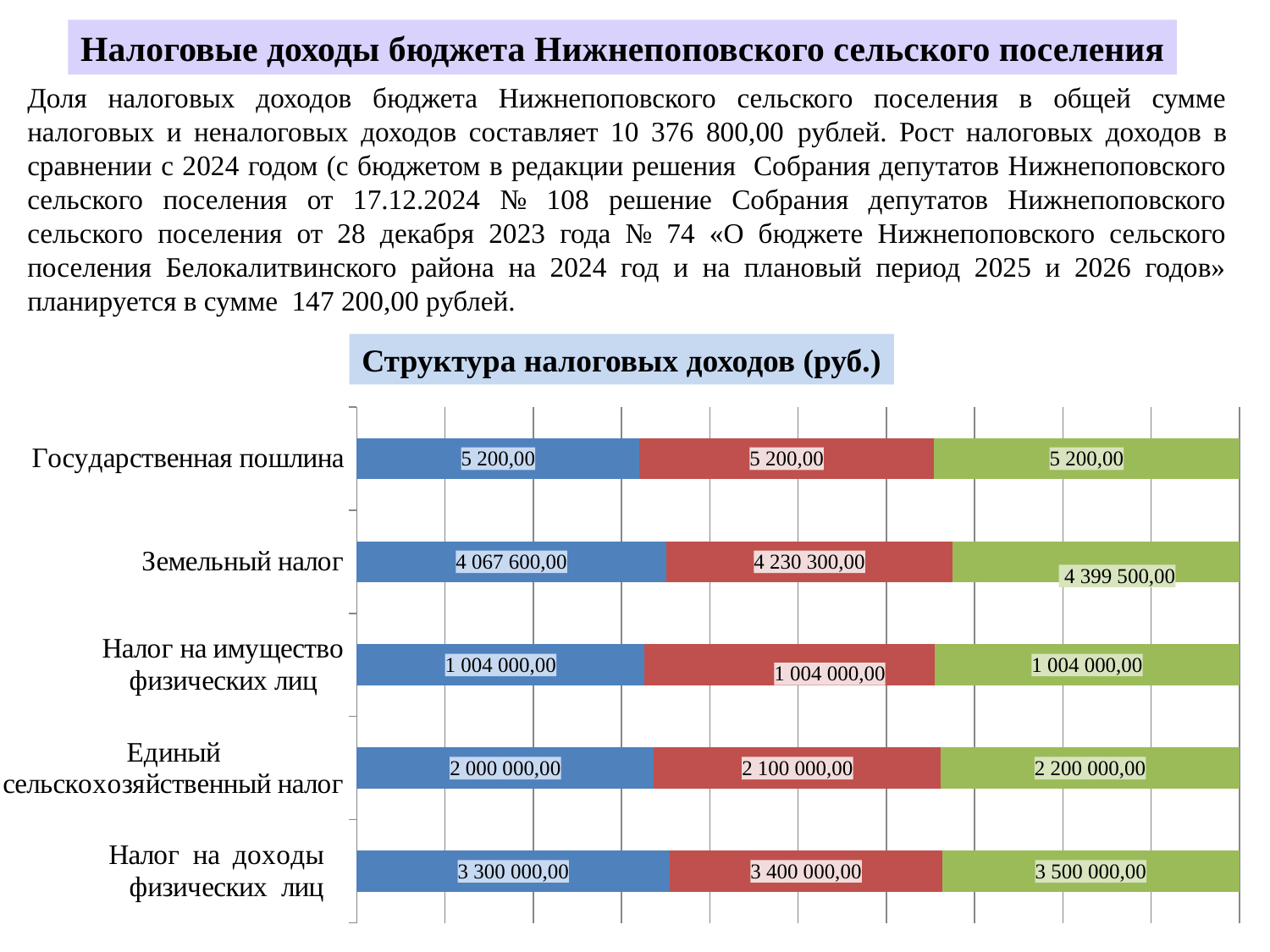
What is the title of the chart on the slide? Структура налоговых доходов (руб.) What is the value of the green segment for «Налог на доходы физических лиц»? 3 500 000,00 What is the value of the red segment for «Единый сельскохозяйственный налог»? 2 100 000,00 What is the total of the three segments for «Единый сельскохозяйственный налог»? 6 300 000,00 Which category has the lowest value in the green segment? Государственная пошлина How many tax categories are listed on the vertical axis of the chart? 5 Which is larger for «Налог на доходы физических лиц»: the blue segment or the green segment? the green segment Which category has the highest value in the blue segment? Земельный налог How many coloured segments does each bar in the chart consist of? 3 What is the value of the blue segment for «Земельный налог»? 4 067 600,00 What is the difference between the green and blue segment values for «Земельный налог»? 331 900,00 What kind of chart is shown under the title «Структура налоговых доходов (руб.)»? stacked bar chart